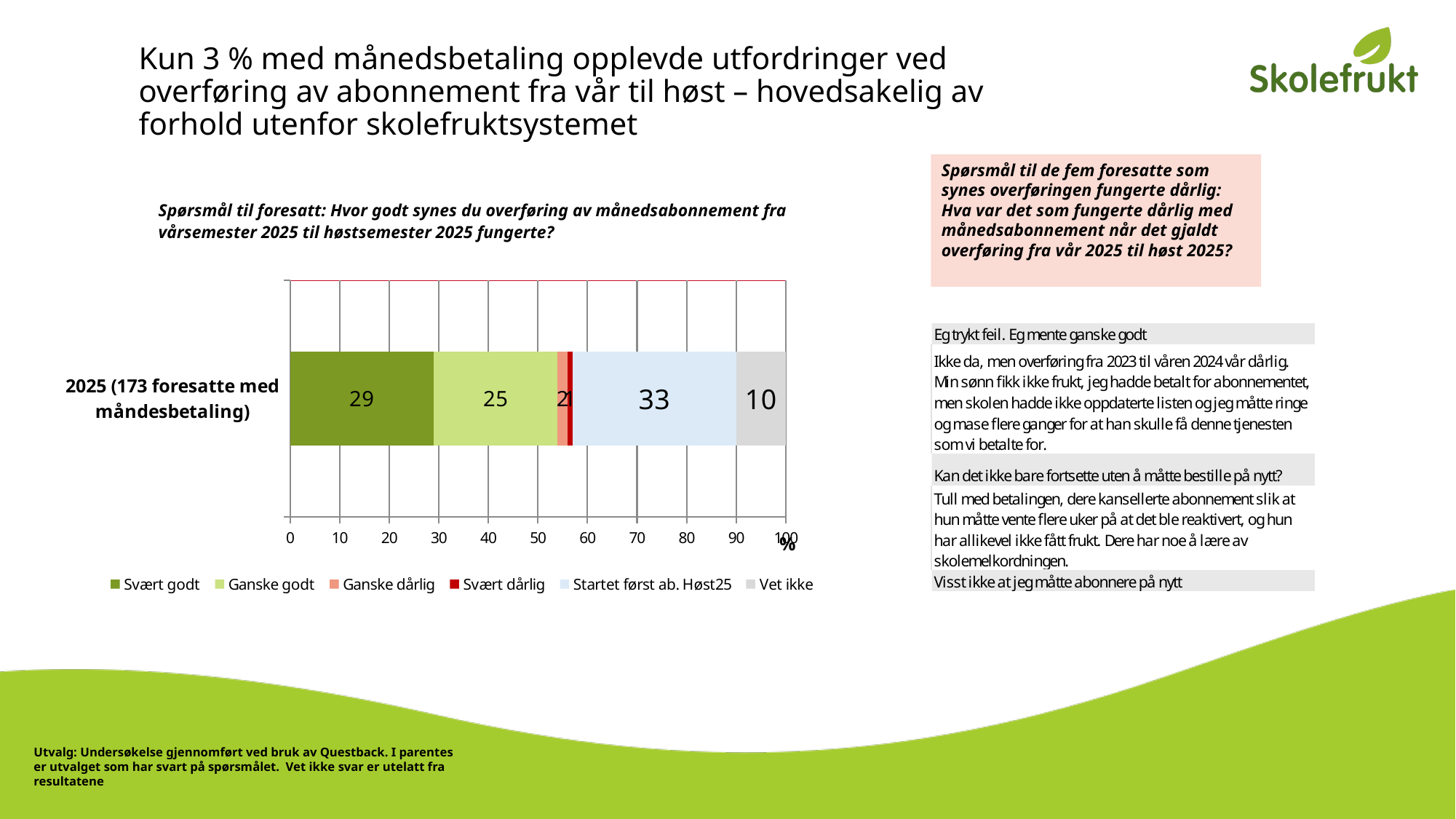
What is the label of the category shown on the chart's vertical axis? 2025 (173 foresatte med måndesbetaling) Which series has the largest segment in the bar? Startet først ab. Høst25 What is the difference between the 'Ganske godt' value and the 'Vet ikke' value? 15 How many categories (bars) are plotted in the chart? 1 What is the difference between the 'Startet først ab. Høst25' value and the 'Svært godt' value? 4 What value is shown for the 'Svært godt' segment of the bar? 29 What value is shown for the 'Ganske godt' segment of the bar? 25 Which is larger, the 'Svært godt' segment or the 'Startet først ab. Høst25' segment? Startet først ab. Høst25 What value is shown for the 'Startet først ab. Høst25' segment of the bar? 33 What kind of chart is shown on the slide? Stacked bar chart What value is shown for the 'Vet ikke' segment of the bar? 10 How many series does the legend list? 6